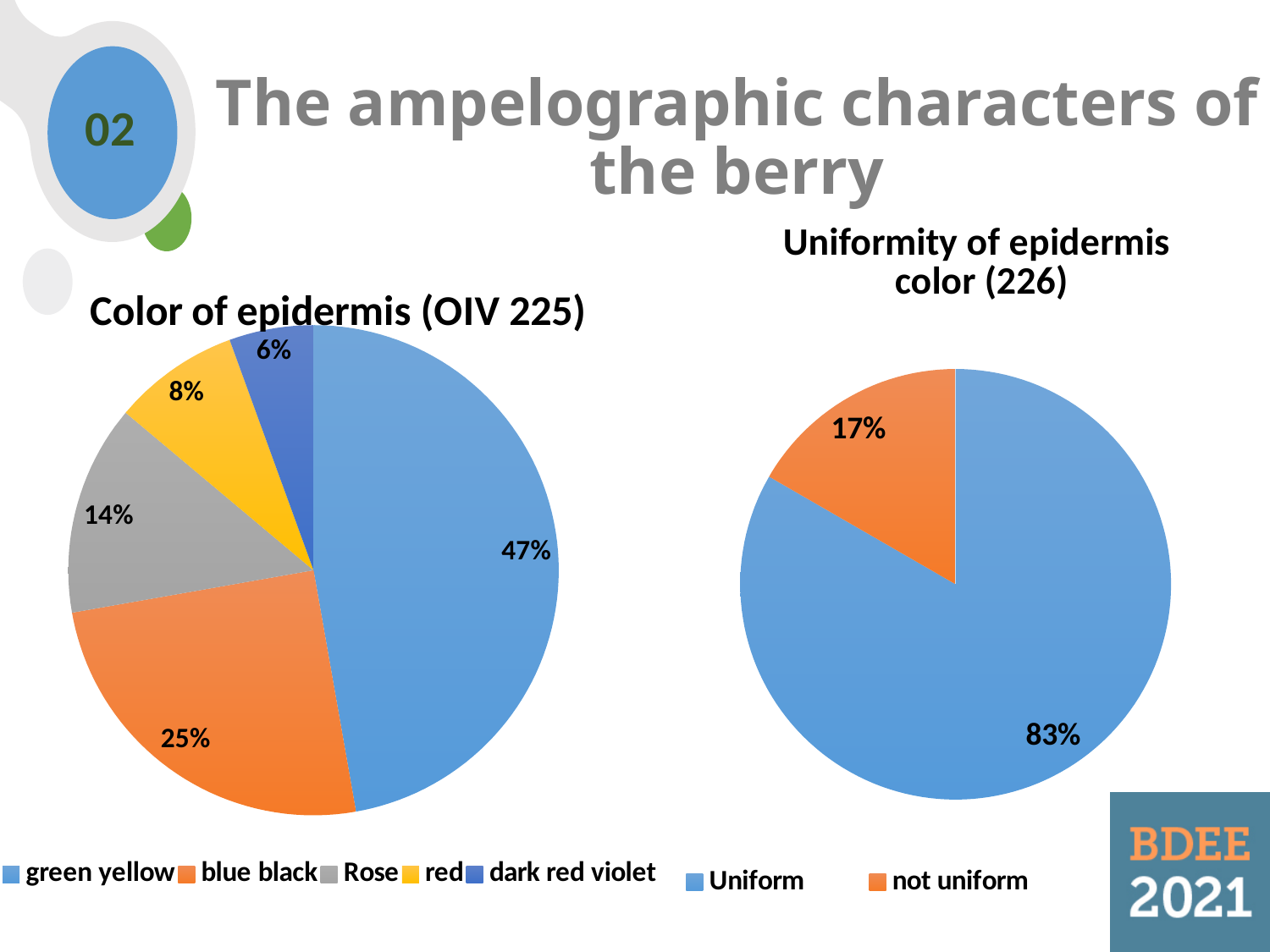
In the 'Uniformity of epidermis color (226)' chart, which is larger, Uniform or not uniform? Uniform In the 'Uniformity of epidermis color (226)' chart, what share is not uniform? 17% What type of chart is the 'Uniformity of epidermis color (226)' chart? pie chart In the 'Uniformity of epidermis color (226)' chart, what share is Uniform? 83% In the 'Color of epidermis (OIV 225)' chart, what share is green yellow? 47% In the 'Color of epidermis (OIV 225)' chart, what share is dark red violet? 6% In the 'Color of epidermis (OIV 225)' chart, what is the difference between the green yellow and blue black shares? 22% In the 'Color of epidermis (OIV 225)' chart, which category has the smallest slice? dark red violet In the 'Color of epidermis (OIV 225)' chart, what share is blue black? 25% In the 'Color of epidermis (OIV 225)' chart, which category has the largest slice? green yellow In the 'Color of epidermis (OIV 225)' chart, how many categories are shown? 5 In the 'Color of epidermis (OIV 225)' chart, what share is Rose? 14%